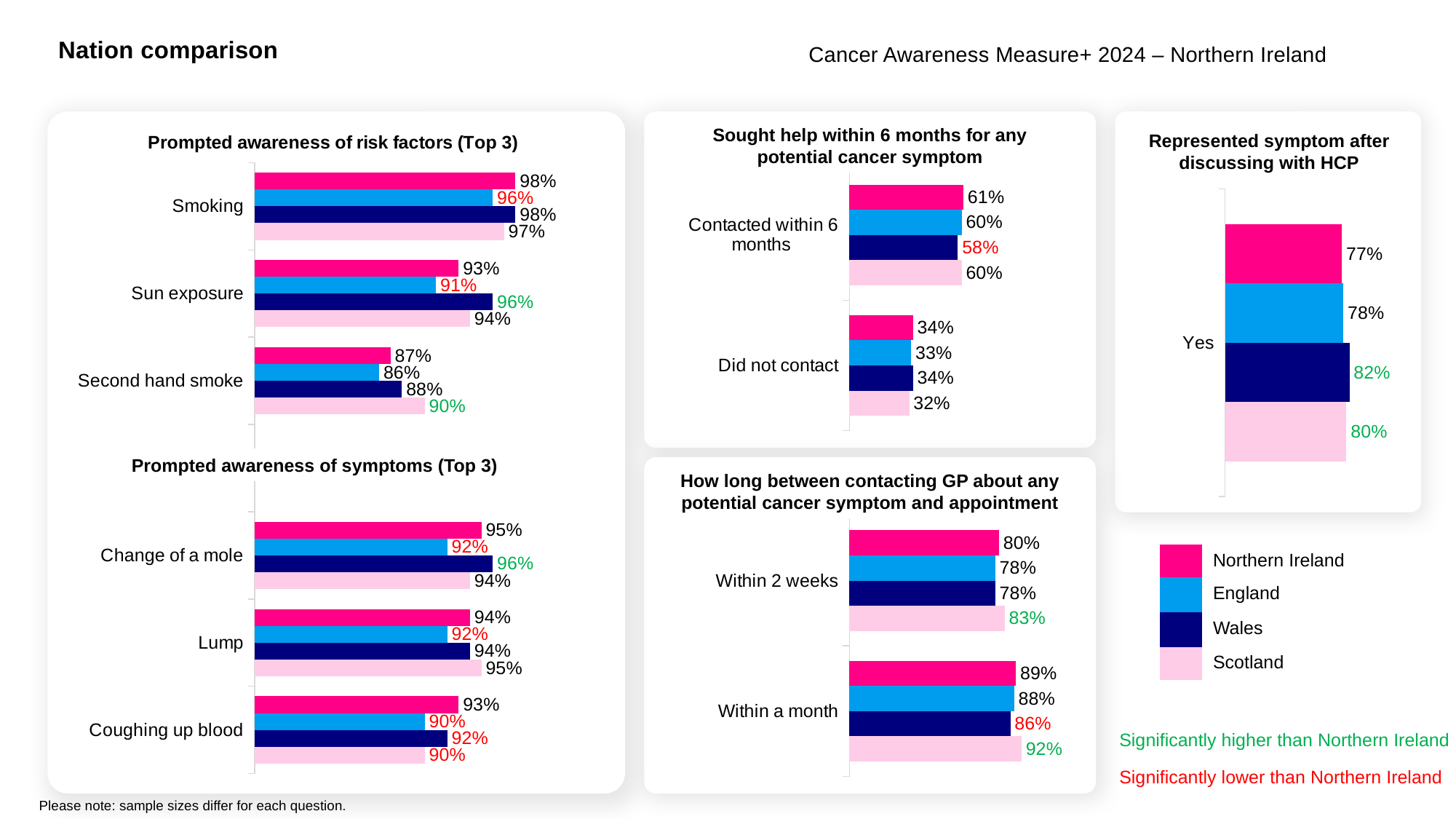
How many nations does the legend list? 4 In the 'Prompted awareness of symptoms (Top 3)' chart, which nation has the highest value for Change of a mole? Wales In the 'Sought help within 6 months for any potential cancer symptom' chart, which nation has the lowest value for Did not contact? Scotland In the 'Represented symptom after discussing with HCP' chart, what is the difference between Wales and Northern Ireland? 5% In the 'Prompted awareness of risk factors (Top 3)' chart, what is the value for Scotland for Second hand smoke? 90% In the 'Sought help within 6 months for any potential cancer symptom' chart, what is the value for Wales for Contacted within 6 months? 58% In the 'Represented symptom after discussing with HCP' chart, what is the value for Wales? 82% In the 'Prompted awareness of symptoms (Top 3)' chart, what is the difference between Northern Ireland and England for Coughing up blood? 3% In the 'Prompted awareness of risk factors (Top 3)' chart, what is the value for England for Sun exposure? 91% In the 'How long between contacting GP about any potential cancer symptom and appointment' chart, what is the value for Scotland for Within a month? 92% In the 'How long between contacting GP about any potential cancer symptom and appointment' chart, which is larger for Within 2 weeks: Northern Ireland or Scotland? Scotland What kind of chart is the 'Prompted awareness of risk factors (Top 3)' chart? Bar chart